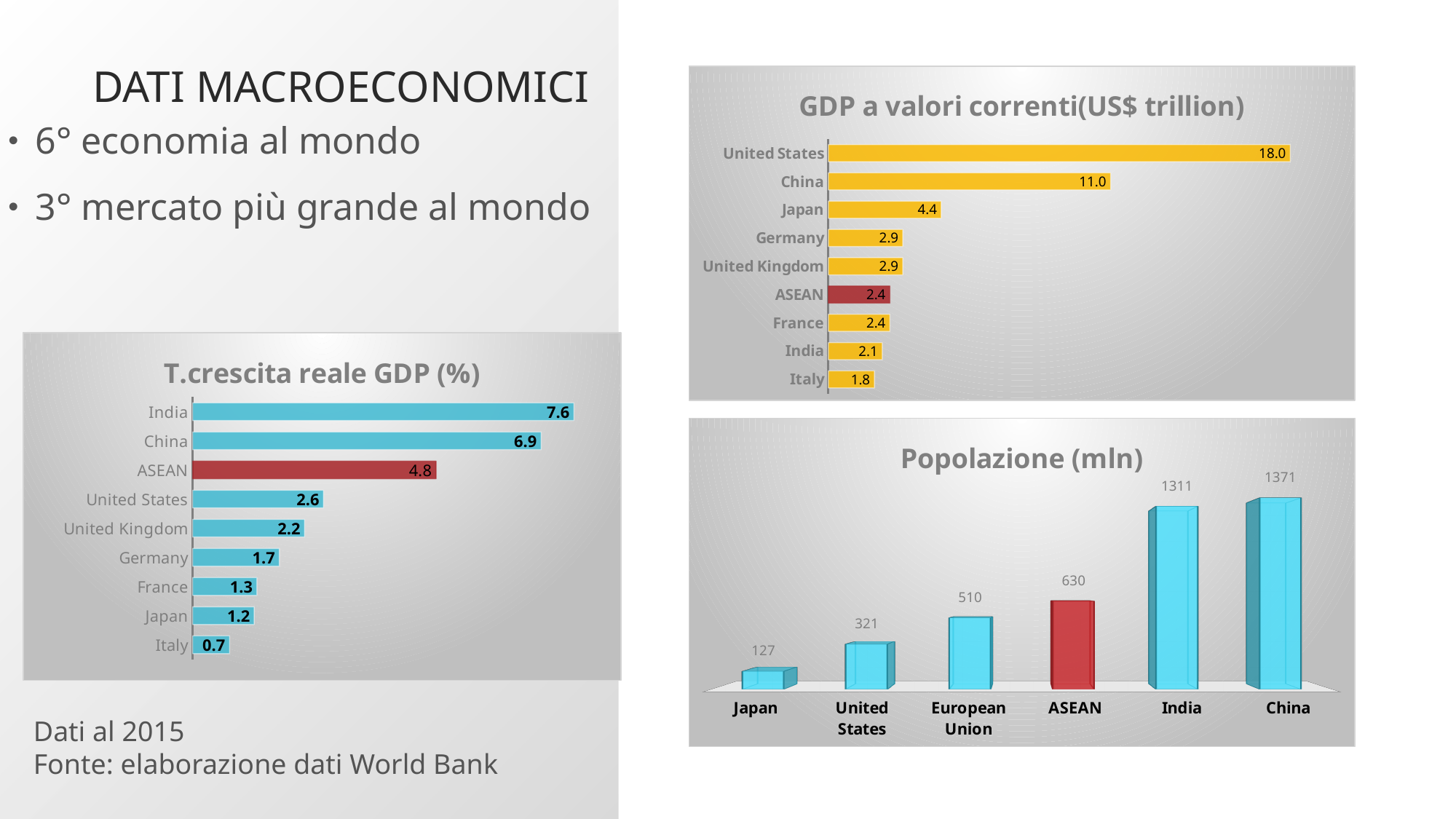
In the 'GDP a valori correnti(US$ trillion)' chart, what is the value for China? 11.0 In the 'T.crescita reale GDP (%)' chart, which category has the highest value? India In the 'T.crescita reale GDP (%)' chart, how many categories are shown? 9 In the 'GDP a valori correnti(US$ trillion)' chart, which is larger, Japan or Germany? Japan In the 'Popolazione (mln)' chart, what is the difference between China and India? 60 In the 'T.crescita reale GDP (%)' chart, what is the value for ASEAN? 4.8 In the 'T.crescita reale GDP (%)' chart, which category has the lowest value? Italy In the 'GDP a valori correnti(US$ trillion)' chart, which category has the highest value? United States In the 'GDP a valori correnti(US$ trillion)' chart, what is the difference between United States and China? 7.0 In the 'Popolazione (mln)' chart, what is the value for European Union? 510 What kind of chart is the 'Popolazione (mln)' chart? Bar chart In the 'T.crescita reale GDP (%)' chart, what is the difference between India and China? 0.7